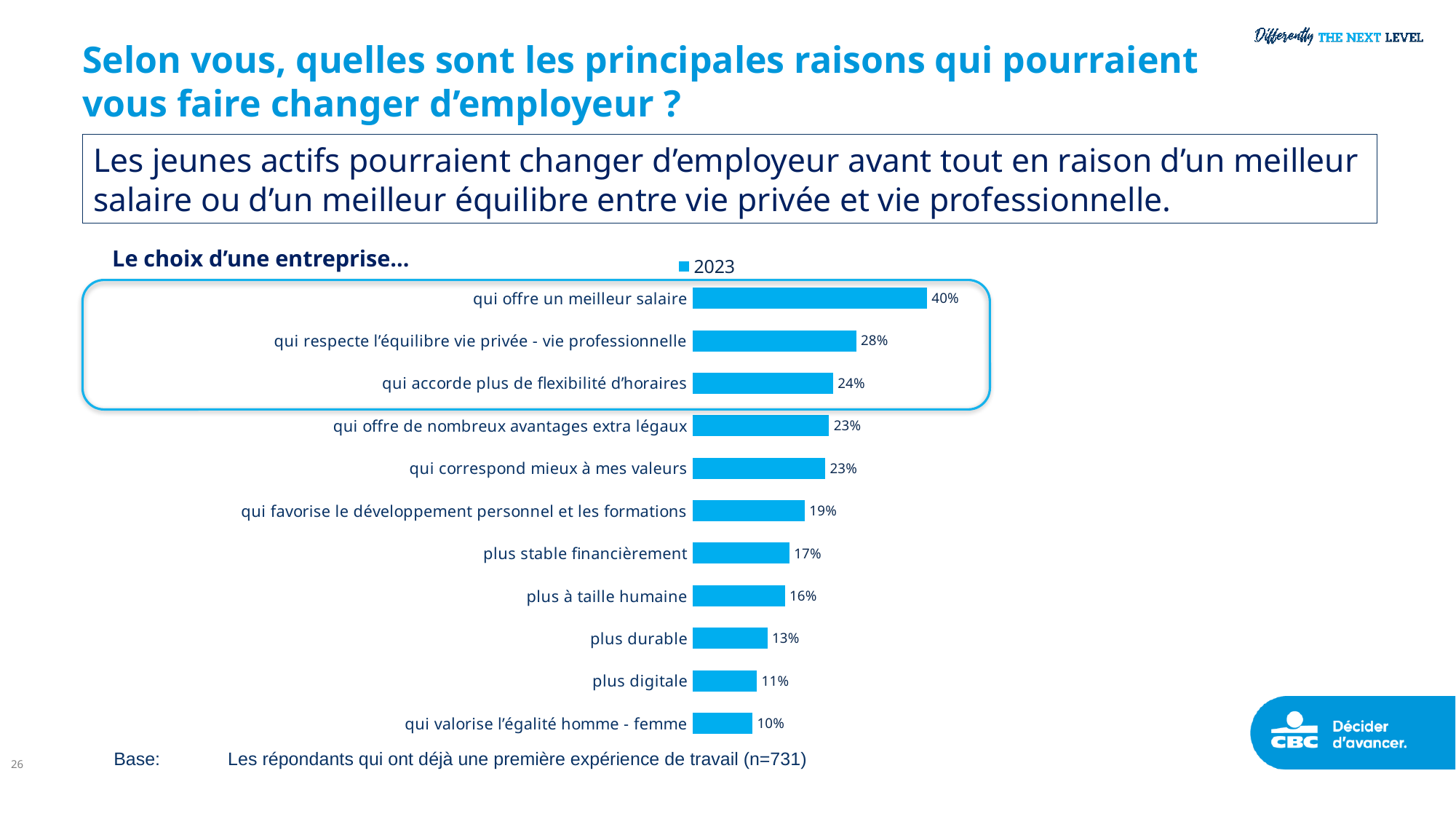
What is the title of the chart? Le choix d'une entreprise… Which is larger: "plus stable financièrement" or "plus à taille humaine"? plus stable financièrement What is the value for "plus durable"? 13% Which category has the lowest value? qui valorise l'égalité homme - femme How many categories are shown in the chart? 11 How many series does the legend list? 1 What is the value for "qui accorde plus de flexibilité d'horaires"? 24% What is the value for "qui offre un meilleur salaire"? 40% What is the difference between "qui offre un meilleur salaire" and "qui respecte l'équilibre vie privée - vie professionnelle"? 12% Which category has the highest value? qui offre un meilleur salaire What series name is shown in the legend? 2023 What kind of chart is shown? bar chart